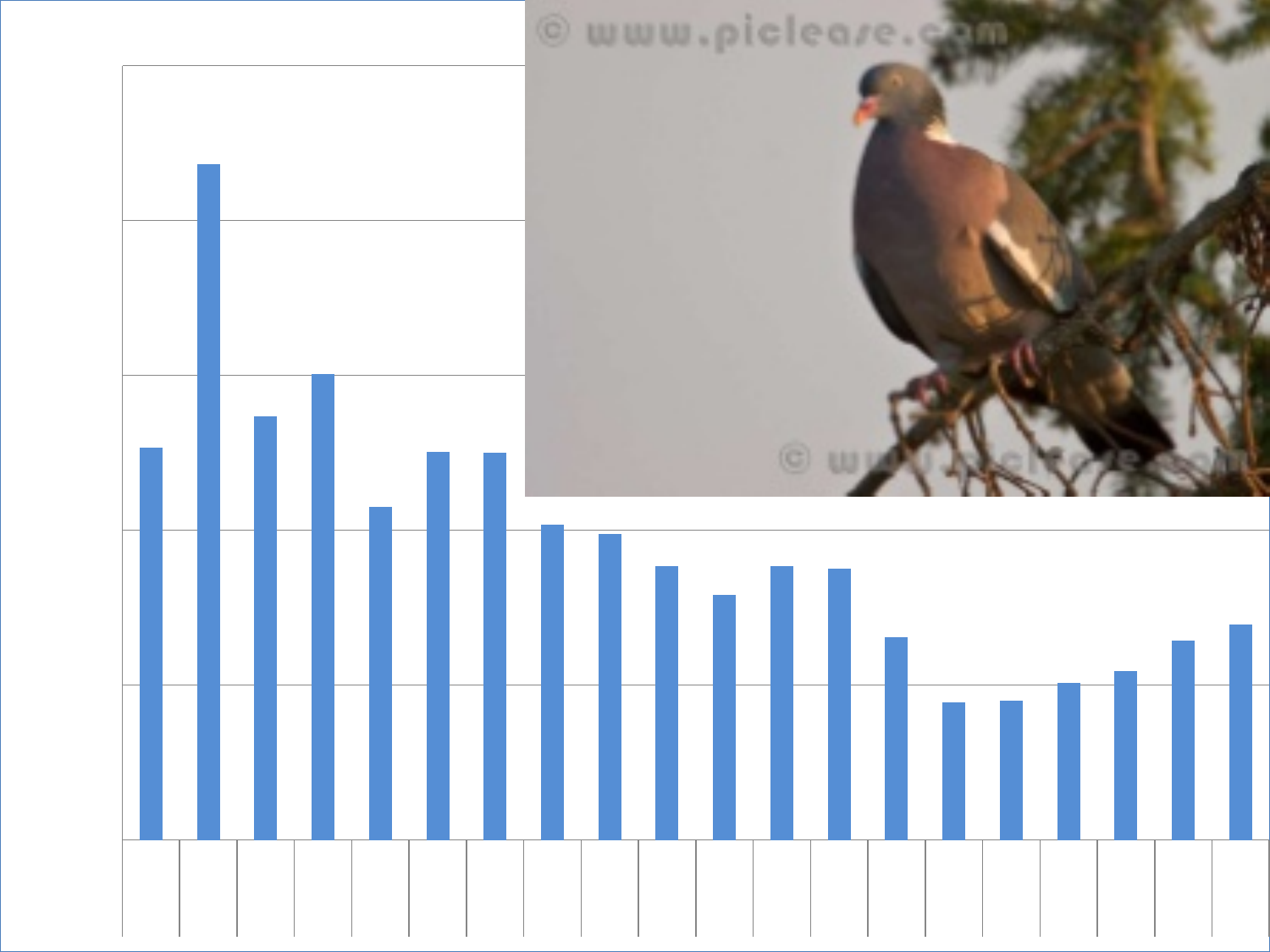
Does the chart display a legend? No Do the bars generally rise or fall from the second bar to the fifteenth bar? fall Which is taller, the second bar from the left or the fourth bar from the left? the second bar How many bars does the chart contain? 20 What colour are the bars in the chart? blue Do the bars rise or fall from the sixteenth bar to the last bar on the right? rise Which is taller, the third bar from the left or the fourth bar from the left? the fourth bar What kind of chart is shown on the slide? bar chart Which bar, counted from the left, is the tallest in the chart? the second bar Which is taller, the first bar from the left or the last bar on the right? the first bar